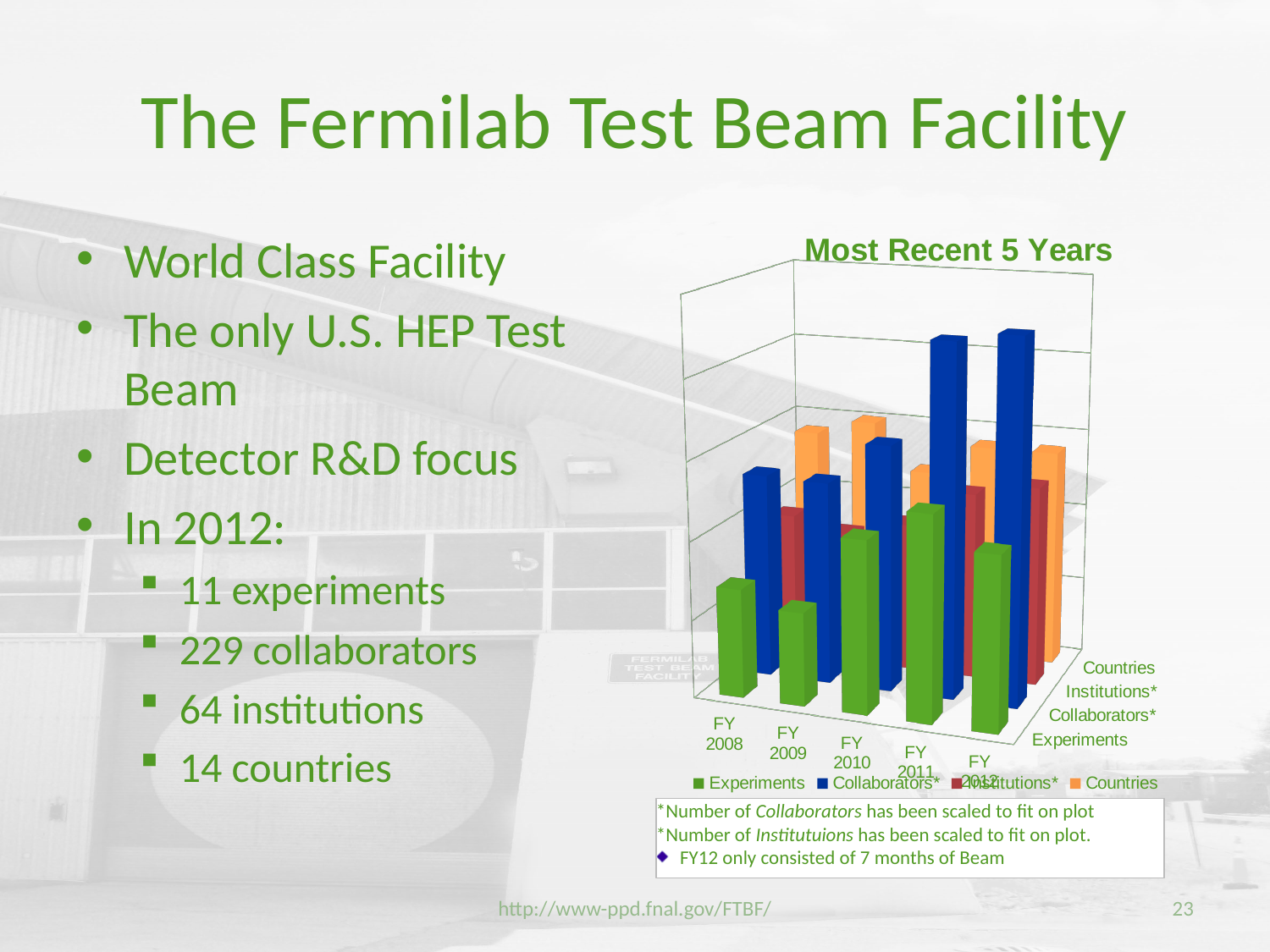
Do the Collaborators* values generally rise or fall from FY 2008 to FY 2012? rise Is the Experiments value larger in FY 2011 or FY 2009? FY 2011 Which fiscal year is the first category on the chart's x axis? FY 2008 Which colour represents the Experiments series in the chart? green What is the title of the chart? Most Recent 5 Years Which fiscal year has the lowest value for Experiments? FY 2009 Which fiscal year has the highest value for Experiments? FY 2011 Is the Collaborators* value larger in FY 2012 or FY 2008? FY 2012 How many series does the chart legend list? 4 How many fiscal years are plotted on the chart? 5 What kind of chart is shown on the slide? bar chart